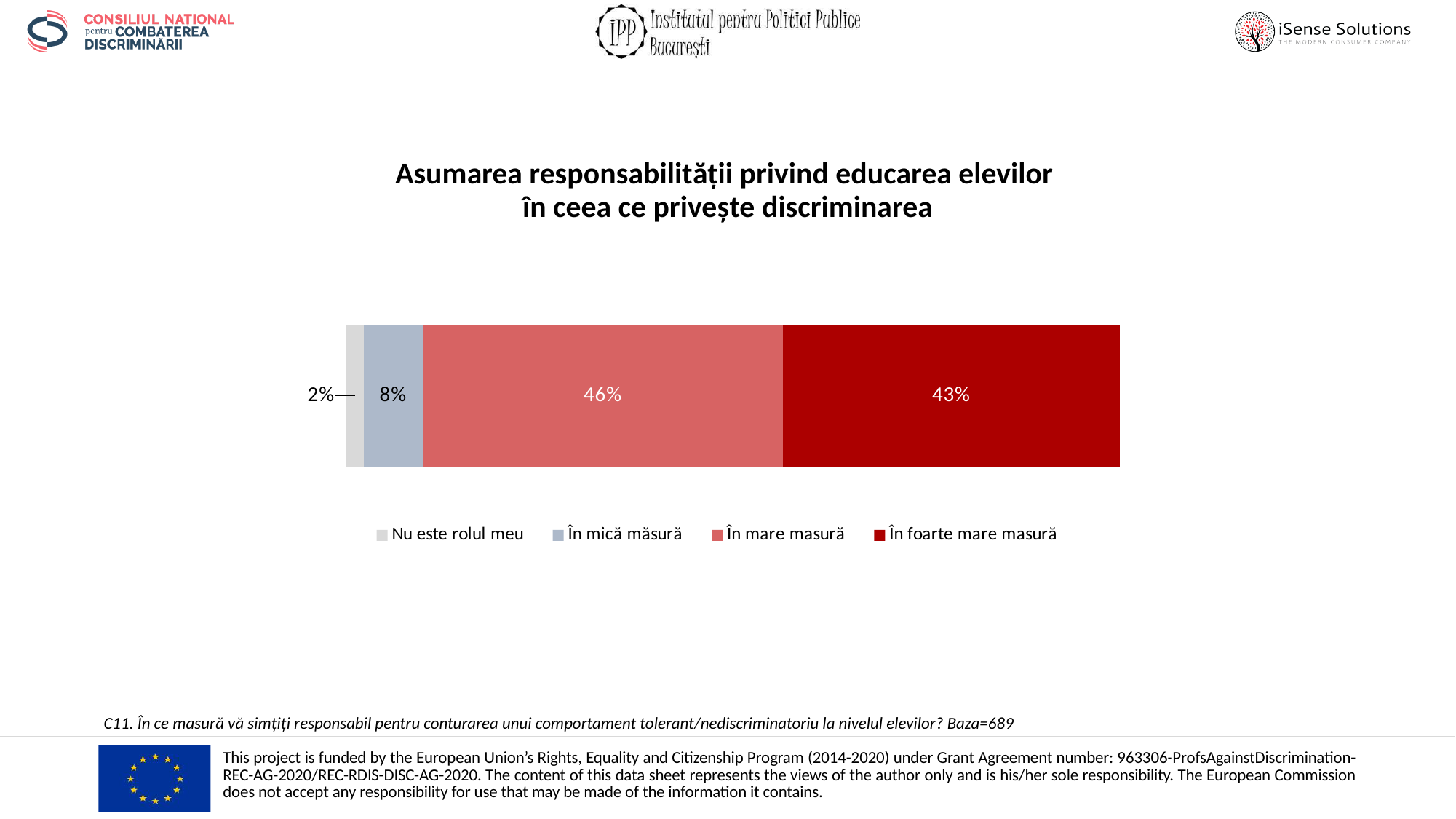
What percentage of respondents answered "În foarte mare masură"? 43% Which is larger: the share for "În mică măsură" or the share for "Nu este rolul meu"? În mică măsură What colour represents "În foarte mare masură" in the chart? Dark red Which response category has the smallest share? Nu este rolul meu What percentage of respondents answered "Nu este rolul meu"? 2% What is the combined share of "În mare masură" and "În foarte mare masură"? 89% What is the difference in percentage points between "În mare masură" and "În foarte mare masură"? 3 What percentage of respondents answered "În mare masură"? 46% What kind of chart is shown on the slide? Stacked bar chart Which response category has the largest share? În mare masură What percentage of respondents answered "În mică măsură"? 8% How many series does the legend list? 4